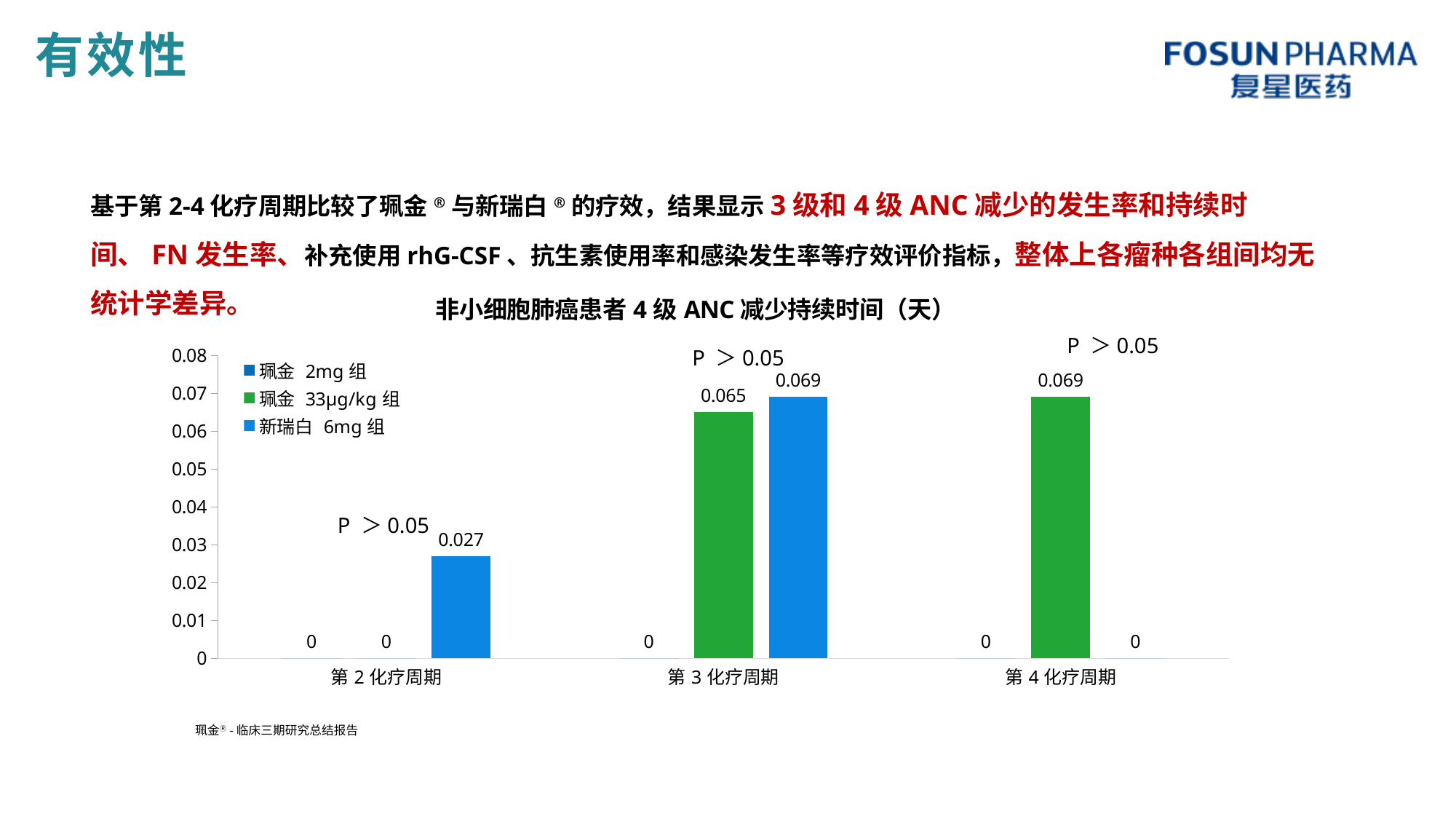
What is the value for the 珮金 33μg/kg 组 series in 第 3 化疗周期? 0.065 What is the title of the chart? 非小细胞肺癌患者 4 级 ANC 减少持续时间（天） How many chemotherapy cycle categories are shown on the x axis? 3 How many series does the legend list? 3 What is the difference between the 新瑞白 6mg 组 values in 第 3 化疗周期 and 第 2 化疗周期? 0.042 In 第 3 化疗周期, which series has the higher value: 珮金 33μg/kg 组 or 新瑞白 6mg 组? 新瑞白 6mg 组 What is the difference between the 新瑞白 6mg 组 and 珮金 33μg/kg 组 values in 第 3 化疗周期? 0.004 What is the value for the 珮金 33μg/kg 组 series in 第 4 化疗周期? 0.069 What is the value for the 新瑞白 6mg 组 series in 第 3 化疗周期? 0.069 What kind of chart is shown on the slide? Bar chart What is the value for the 珮金 2mg 组 series in 第 3 化疗周期? 0 What is the value for the 新瑞白 6mg 组 series in 第 2 化疗周期? 0.027